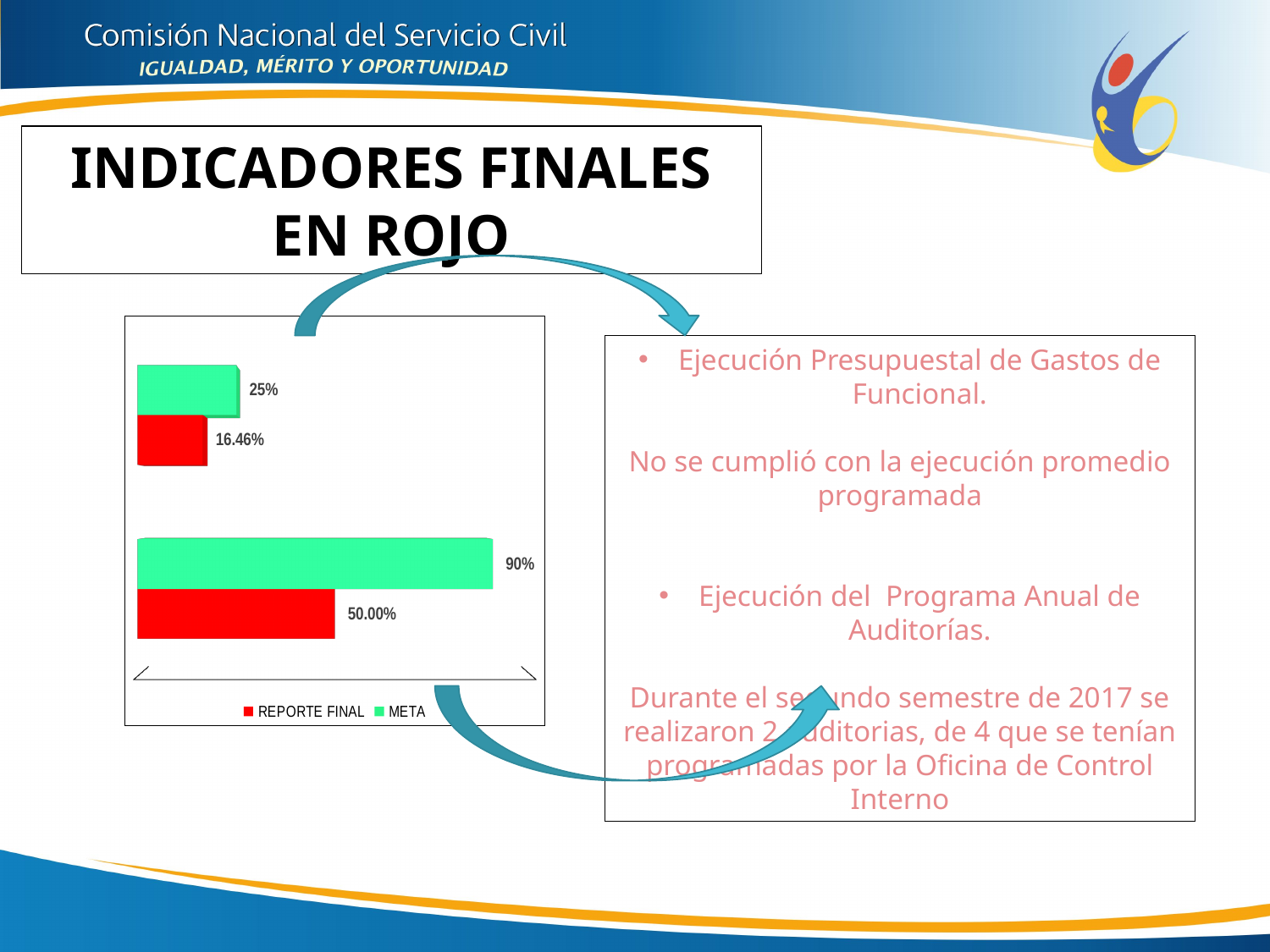
What is the REPORTE FINAL value for the bottom group of bars? 50.00% How many groups of bars does the chart show? 2 What is the META value for the top group of bars? 25% Which colour represents the REPORTE FINAL series in the chart? red What is the lowest value shown in the chart? 16.46% In the bottom group of bars, what is the difference between the META value and the REPORTE FINAL value? 40% What is the highest value shown in the chart? 90% In the top group of bars, which is larger, META or REPORTE FINAL? META What kind of chart is shown on the slide? bar chart What is the REPORTE FINAL value for the top group of bars? 16.46% How many series does the chart legend list? 2 What is the META value for the bottom group of bars? 90%